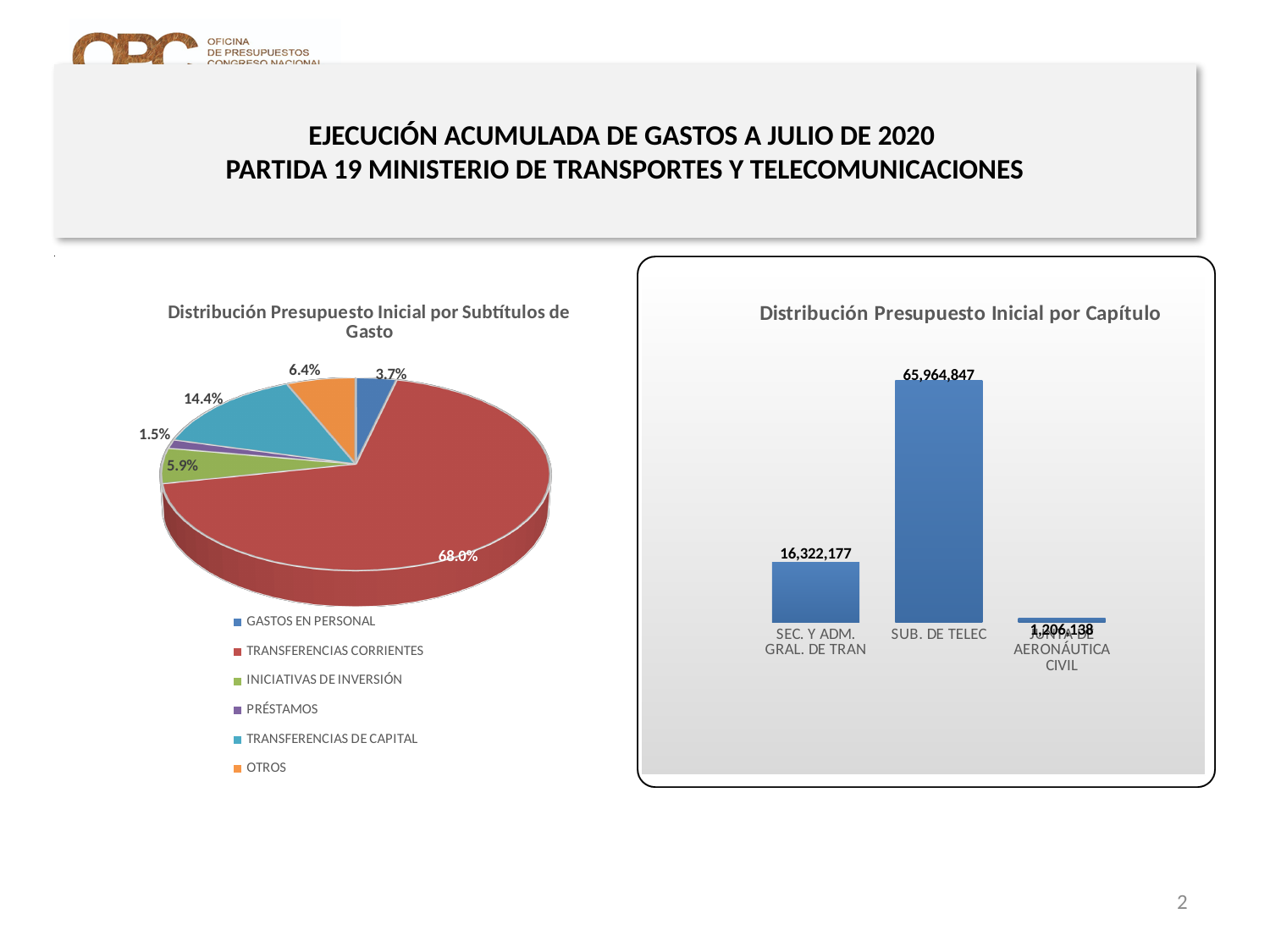
In the chart 'Distribución Presupuesto Inicial por Capítulo', how many categories are shown? 3 In the chart 'Distribución Presupuesto Inicial por Capítulo', what is the value for SUB. DE TELEC? 65,964,847 In the chart 'Distribución Presupuesto Inicial por Capítulo', what is the difference between SUB. DE TELEC and SEC. Y ADM. GRAL. DE TRAN? 49,642,670 In the pie chart 'Distribución Presupuesto Inicial por Subtítulos de Gasto', which category has the smallest slice? PRÉSTAMOS In the pie chart 'Distribución Presupuesto Inicial por Subtítulos de Gasto', which is larger: OTROS or INICIATIVAS DE INVERSIÓN? OTROS In the chart 'Distribución Presupuesto Inicial por Capítulo', what is the value for SEC. Y ADM. GRAL. DE TRAN? 16,322,177 In the pie chart 'Distribución Presupuesto Inicial por Subtítulos de Gasto', what share does TRANSFERENCIAS DE CAPITAL have? 14.4% In the pie chart 'Distribución Presupuesto Inicial por Subtítulos de Gasto', what share does TRANSFERENCIAS CORRIENTES have? 68.0% In the chart 'Distribución Presupuesto Inicial por Capítulo', which category has the lowest value? JUNTA DE AERONÁUTICA CIVIL In the chart 'Distribución Presupuesto Inicial por Capítulo', which category has the highest value? SUB. DE TELEC In the chart 'Distribución Presupuesto Inicial por Capítulo', what is the value for JUNTA DE AERONÁUTICA CIVIL? 1,206,138 What kind of chart is 'Distribución Presupuesto Inicial por Capítulo'? Bar chart